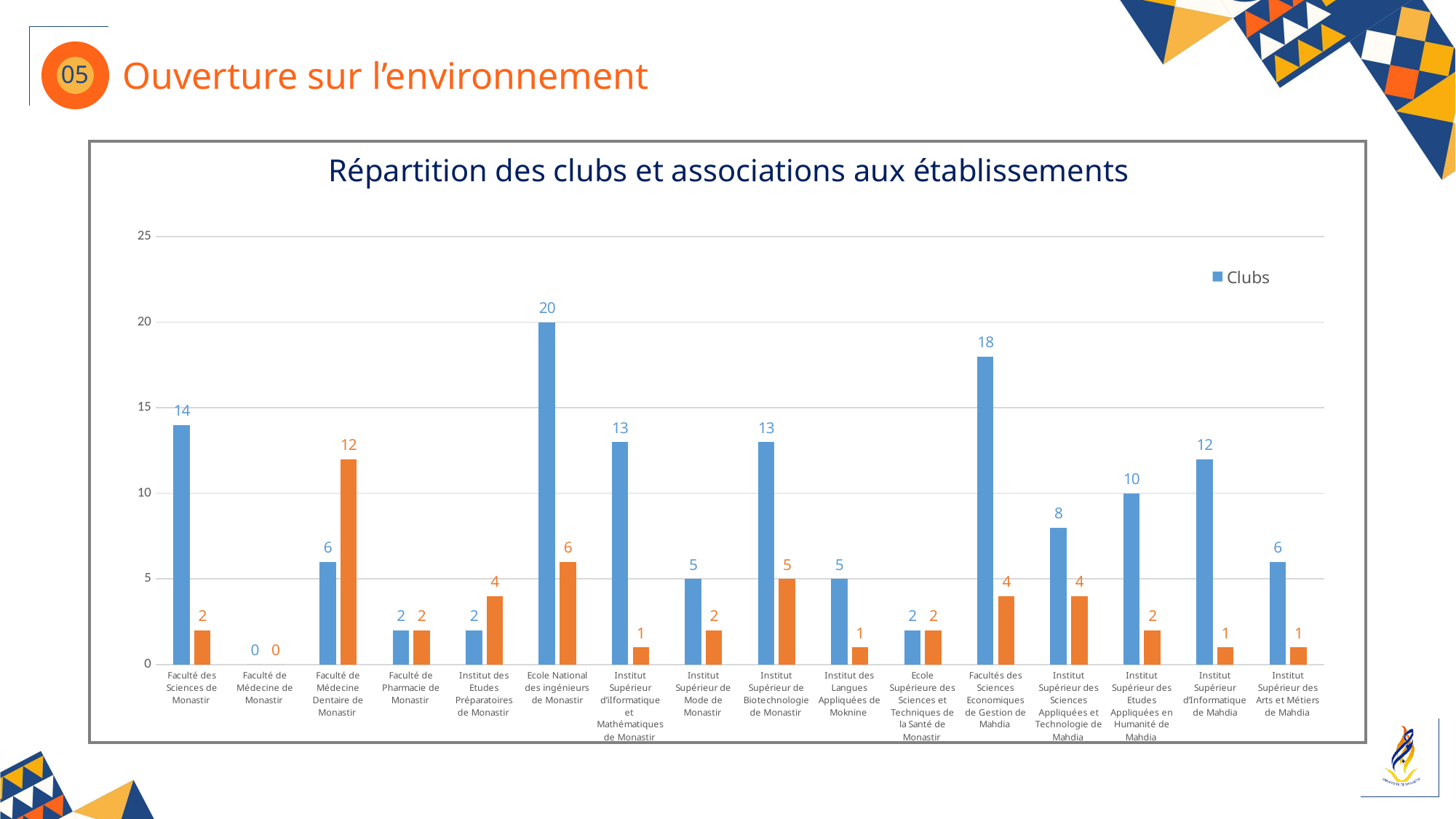
How many clubs does the Ecole National des ingénieurs de Monastir have? 20 What is the title of the chart? Répartition des clubs et associations aux établissements Which establishment has the lowest number of clubs? Faculté de Médecine de Monastir Which has more clubs: the Institut Supérieur d'Informatique de Mahdia or the Institut Supérieur des Etudes Appliquées en Humanité de Mahdia? Institut Supérieur d'Informatique de Mahdia What is the difference in clubs between the Ecole National des ingénieurs de Monastir and the Facultés des Sciences Economiques de Gestion de Mahdia? 2 How many series does the chart legend list? 1 How many establishments are shown on the x axis of the chart? 16 What is the Clubs value for the Institut Supérieur de Biotechnologie de Monastir? 13 Which establishment has the highest number of clubs? Ecole National des ingénieurs de Monastir What is the Clubs value for the Facultés des Sciences Economiques de Gestion de Mahdia? 18 What type of chart is shown on the slide? Bar chart What is the value of the orange bar for the Faculté de Médecine Dentaire de Monastir? 12